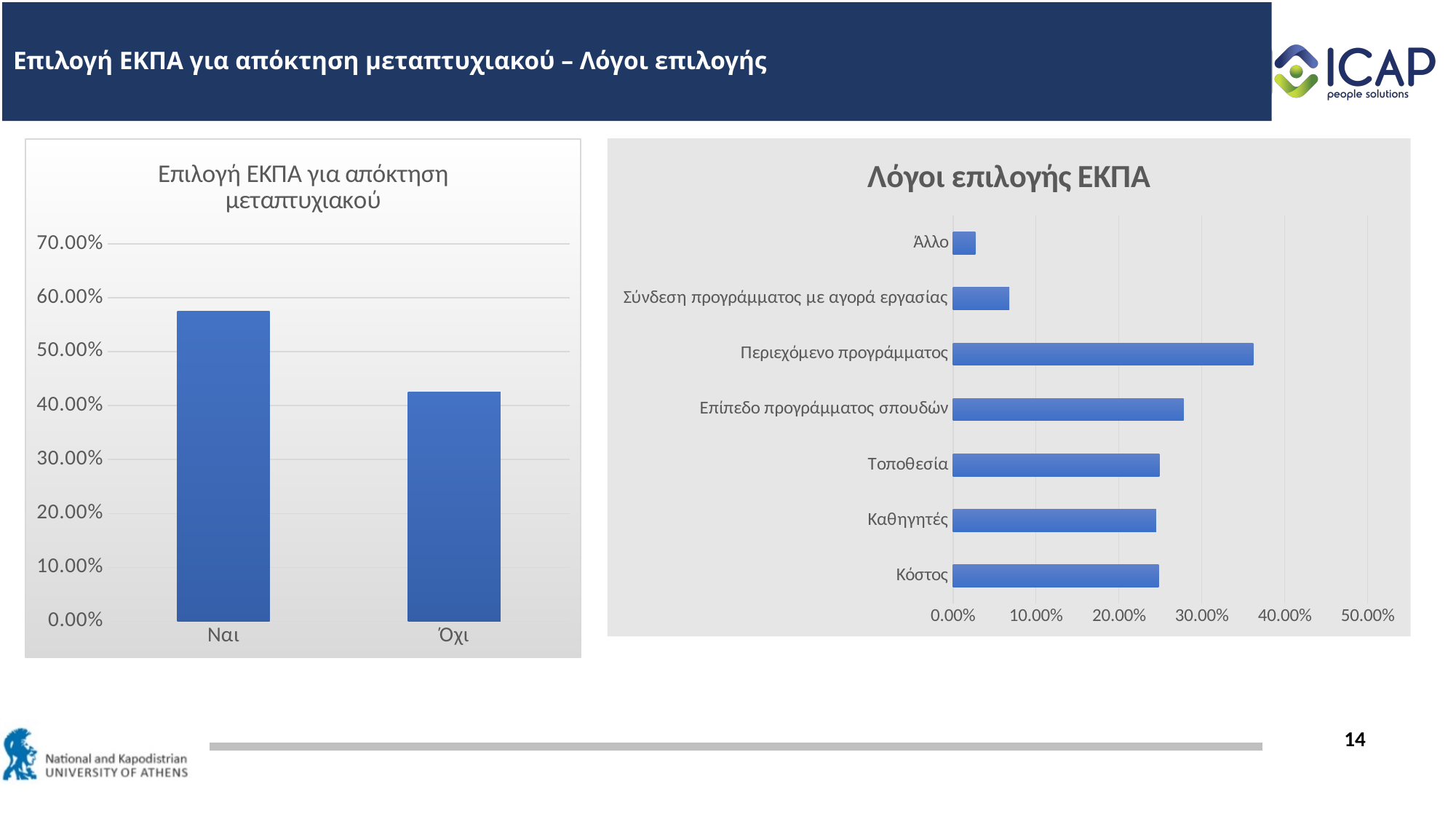
In the chart titled 'Επιλογή ΕΚΠΑ για απόκτηση μεταπτυχιακού', how many categories are plotted? 2 In the chart titled 'Λόγοι επιλογής ΕΚΠΑ', is the value for Περιεχόμενο προγράμματος greater or less than 30.00%? greater In the chart titled 'Λόγοι επιλογής ΕΚΠΑ', which category has the highest value? Περιεχόμενο προγράμματος In the chart titled 'Επιλογή ΕΚΠΑ για απόκτηση μεταπτυχιακού', is the value for Όχι greater or less than 50.00%? less In the chart titled 'Λόγοι επιλογής ΕΚΠΑ', which is larger: Επίπεδο προγράμματος σπουδών or Τοποθεσία? Επίπεδο προγράμματος σπουδών In the chart titled 'Επιλογή ΕΚΠΑ για απόκτηση μεταπτυχιακού', which category has the higher value? Ναι In the chart titled 'Λόγοι επιλογής ΕΚΠΑ', which category has the lowest value? Άλλο In the chart titled 'Λόγοι επιλογής ΕΚΠΑ', how many categories are plotted? 7 In the chart titled 'Επιλογή ΕΚΠΑ για απόκτηση μεταπτυχιακού', what kind of chart is shown? bar chart In the chart titled 'Επιλογή ΕΚΠΑ για απόκτηση μεταπτυχιακού', is the value for Ναι greater or less than 50.00%? greater In the chart titled 'Λόγοι επιλογής ΕΚΠΑ', what is the highest value shown on the horizontal axis? 50.00%